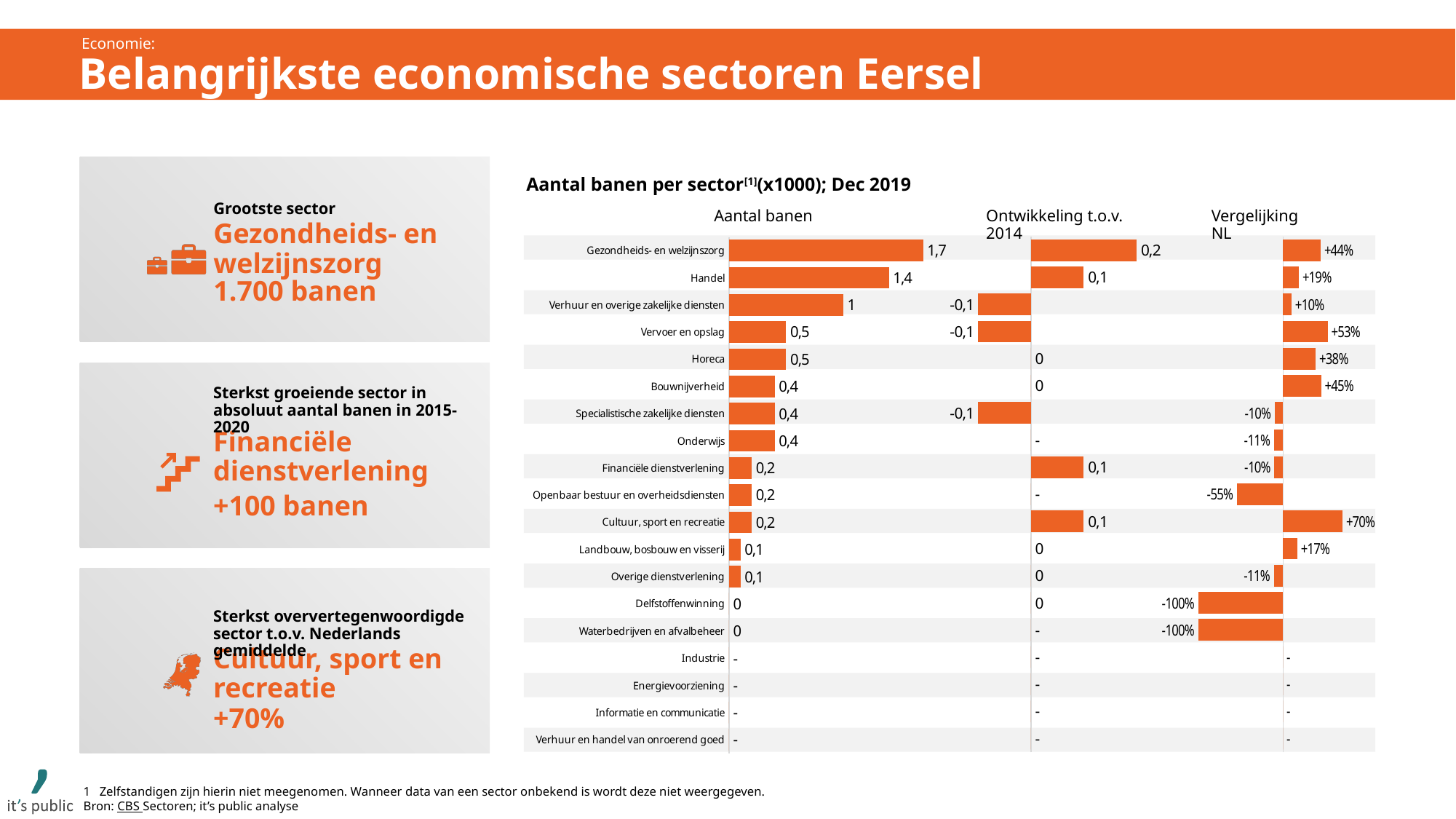
In the 'Vergelijking NL' column, which sector has the highest value? Cultuur, sport en recreatie How many sectors are listed in the chart? 19 In the 'Aantal banen' column, what is the difference between Gezondheids- en welzijnszorg and Handel? 0,3 In the 'Aantal banen' column, which is larger: Verhuur en overige zakelijke diensten or Vervoer en opslag? Verhuur en overige zakelijke diensten What type of chart is used to show the values in the 'Aantal banen' column? Bar chart In the 'Vergelijking NL' column, what is the value for Openbaar bestuur en overheidsdiensten? -55% In the 'Vergelijking NL' column, which is larger: Vervoer en opslag or Bouwnijverheid? Vervoer en opslag What is the title of the chart? Aantal banen per sector (x1000); Dec 2019 In the 'Vergelijking NL' column, what is the value for Cultuur, sport en recreatie? +70% In the 'Ontwikkeling t.o.v. 2014' column, what is the value for Vervoer en opslag? -0,1 In the 'Aantal banen' column, what is the value for Handel? 1,4 In the 'Aantal banen' column, which sector has the highest number of jobs? Gezondheids- en welzijnszorg